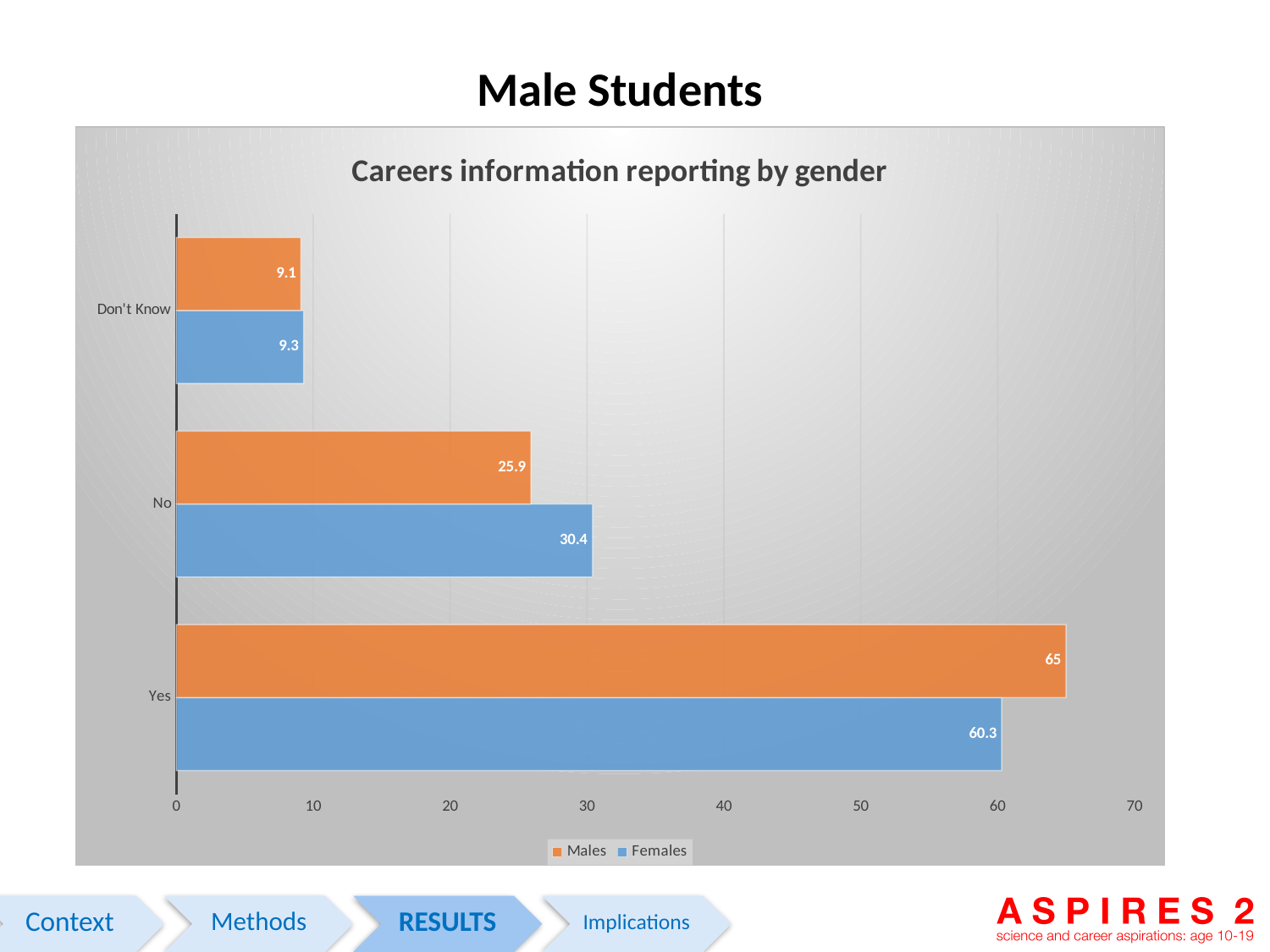
Is the value for Males in the No category greater or less than 30? less What is the difference between the Males and Females values in the Yes category? 4.7 What is the value for Females in the Don't Know category? 9.3 How many categories are shown on the chart? 3 What is the value for Females in the No category? 30.4 Which category has the lowest value for Females? Don't Know What is the value for Males in the Yes category? 65 Which category has the highest value for Males? Yes In the No category, which series has the larger value, Males or Females? Females How many series does the legend list? 2 What kind of chart is shown on the slide? bar chart What is the title of the chart? Careers information reporting by gender